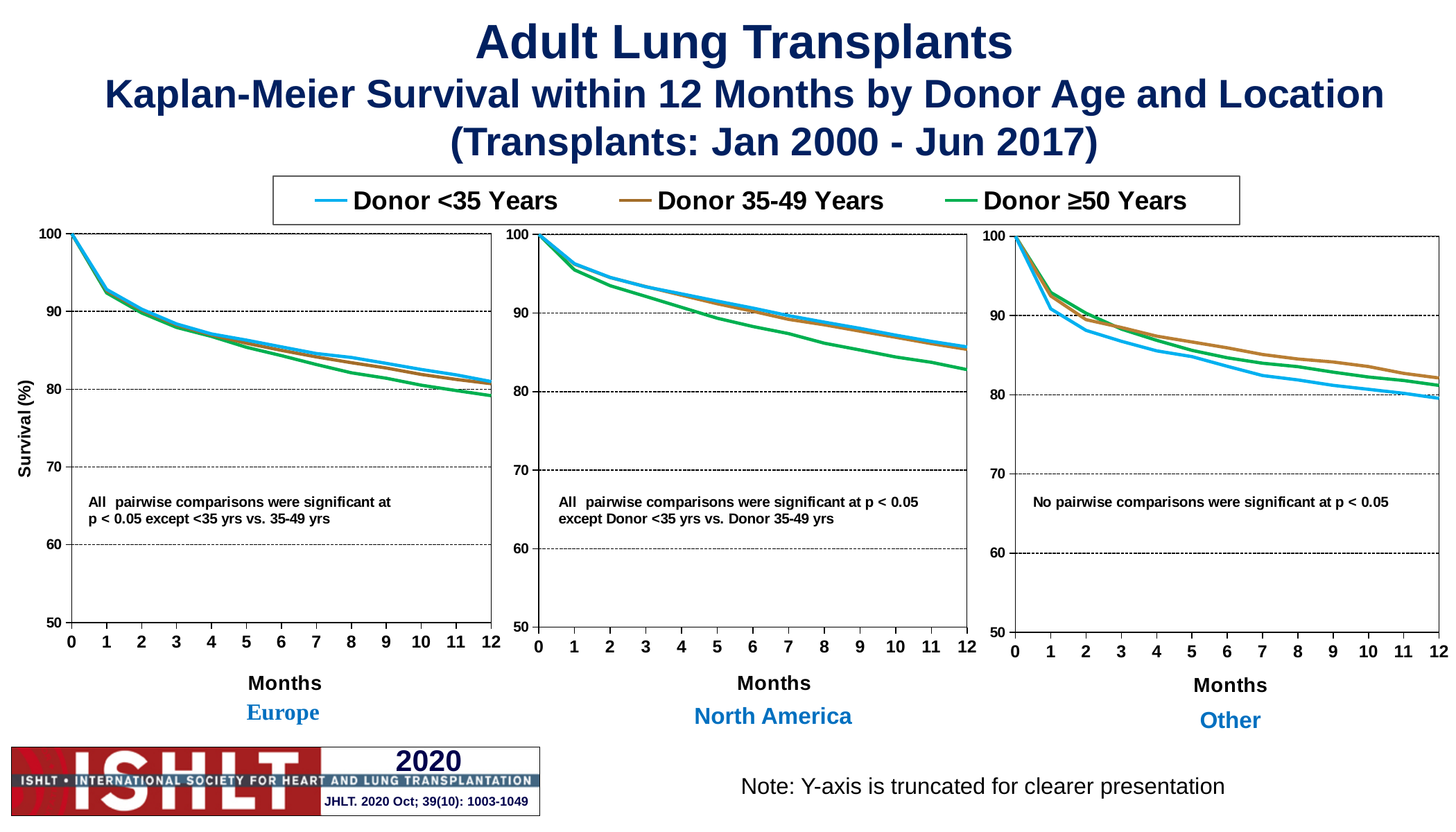
How many series does the legend list? 3 In the Europe chart, what is the survival value for Donor <35 Years at month 0? 100 In the Other chart, which donor group has the lowest survival at 12 months? Donor <35 Years In the North America chart, at 12 months, which is higher: Donor <35 Years or Donor ≥50 Years? Donor <35 Years In the North America chart, which donor group has the lowest survival at 12 months? Donor ≥50 Years In the Europe chart, do the survival curves rise or fall as months increase? fall In the Europe chart, is the survival for Donor ≥50 Years at 12 months greater or less than 80? less In the North America chart, is the survival for Donor <35 Years at 12 months greater or less than 90? less In the Other chart, is the survival for Donor <35 Years at 12 months greater or less than 80? less What kind of chart is used for the Europe panel? line chart What colour is the line for Donor ≥50 Years in the legend? green How many charts (location panels) are shown on the slide? 3